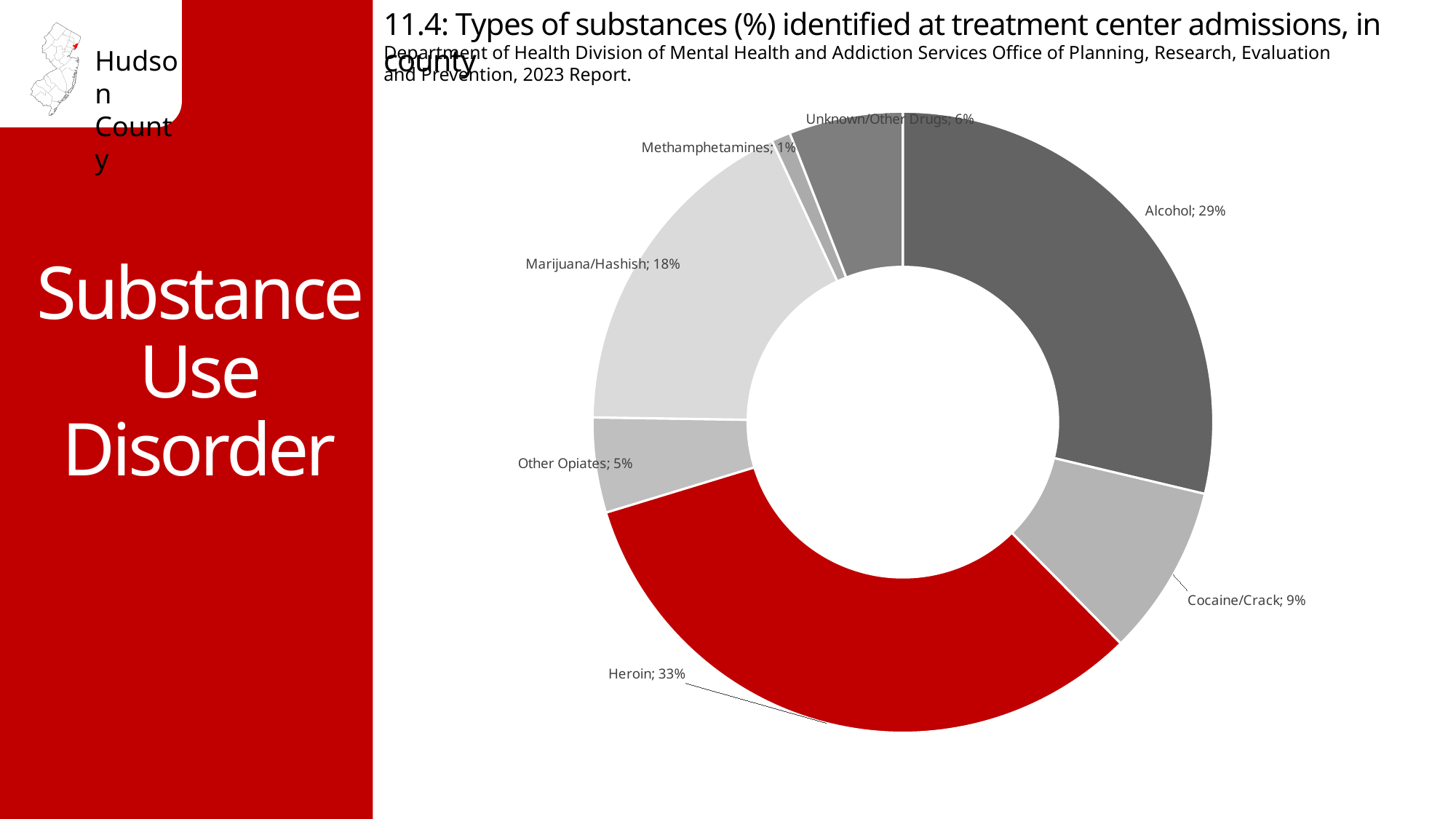
Which substance has the smallest share of treatment center admissions? Methamphetamines What percentage of treatment center admissions is attributed to Heroin? 33% How many substance categories are shown in the chart? 7 What percentage is shown for Cocaine/Crack? 9% Which slice of the chart is coloured red? Heroin What is the difference in percentage points between Marijuana/Hashish and Other Opiates? 13 What percentage is shown for Marijuana/Hashish? 18% What type of chart is used to show the types of substances? Doughnut (pie) chart Which substance has the largest share of treatment center admissions? Heroin What is the difference in percentage points between Heroin and Alcohol? 4 Which has a larger share, Cocaine/Crack or Unknown/Other Drugs? Cocaine/Crack What percentage of treatment center admissions is attributed to Alcohol? 29%